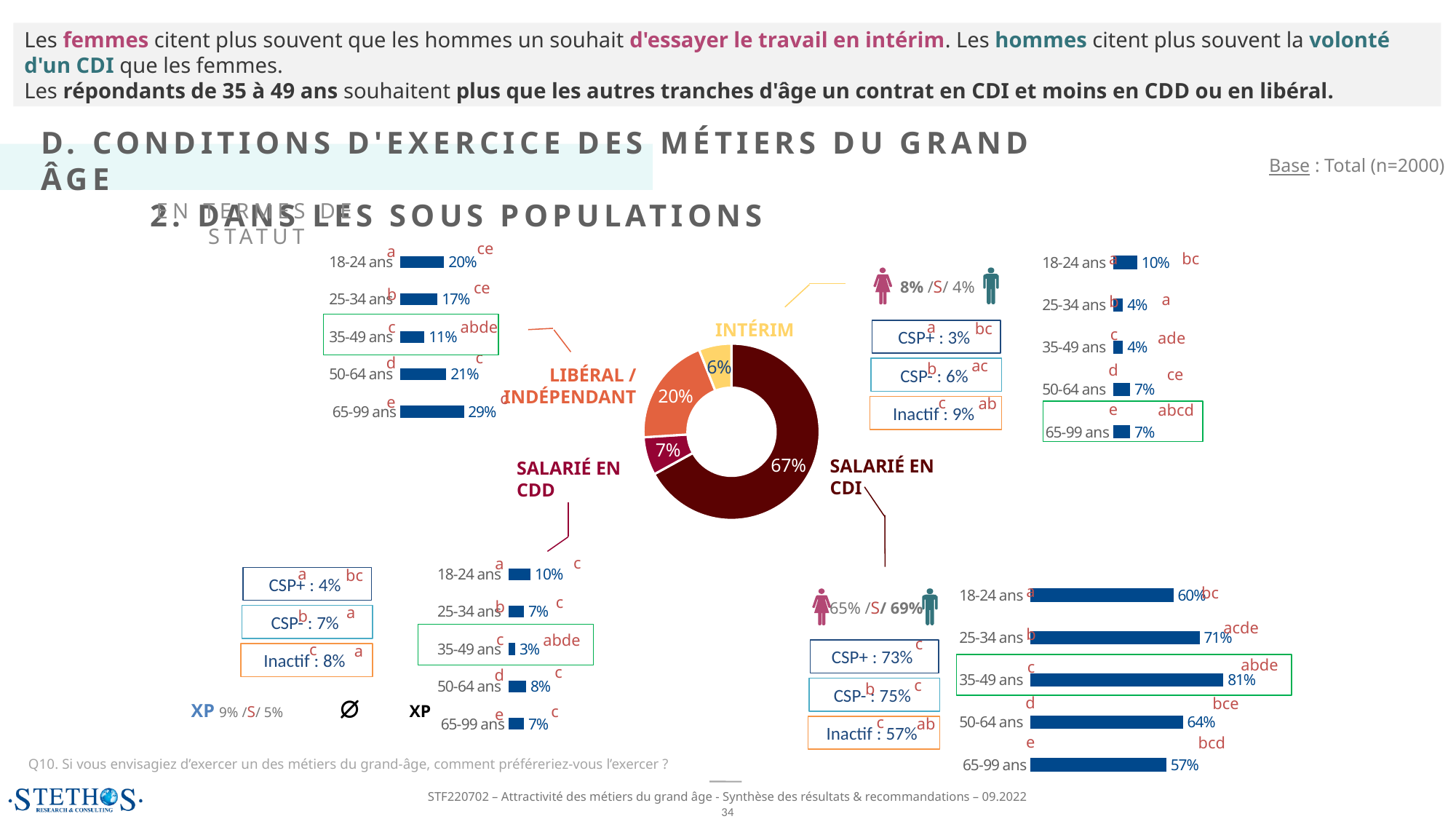
In the Salarié en CDD bar chart (bottom left), what is the value for 35-49 ans? 3% In the Salarié en CDI bar chart (bottom right), which age group has the highest value? 35-49 ans In the Libéral / Indépendant bar chart (top left), what is the value for 65-99 ans? 29% In the central donut chart, which status has the smallest share? Intérim In the Libéral / Indépendant bar chart (top left), which age group has the lowest value? 35-49 ans In the central donut chart, what is the difference between the Salarié en CDI share and the Libéral / Indépendant share? 47 percentage points In the central donut chart, what share is shown for Libéral / Indépendant? 20% What kind of chart is the central chart showing the breakdown by status (Intérim, Libéral / Indépendant, Salarié en CDD, Salarié en CDI)? Donut (pie) chart In the Salarié en CDI bar chart (bottom right), what is the value for 65-99 ans? 57% In the Intérim bar chart (top right), which is larger: the value for 18-24 ans or the value for 25-34 ans? 18-24 ans How many segments does the central donut chart have? 4 In the central donut chart, what share is shown for Salarié en CDI? 67%